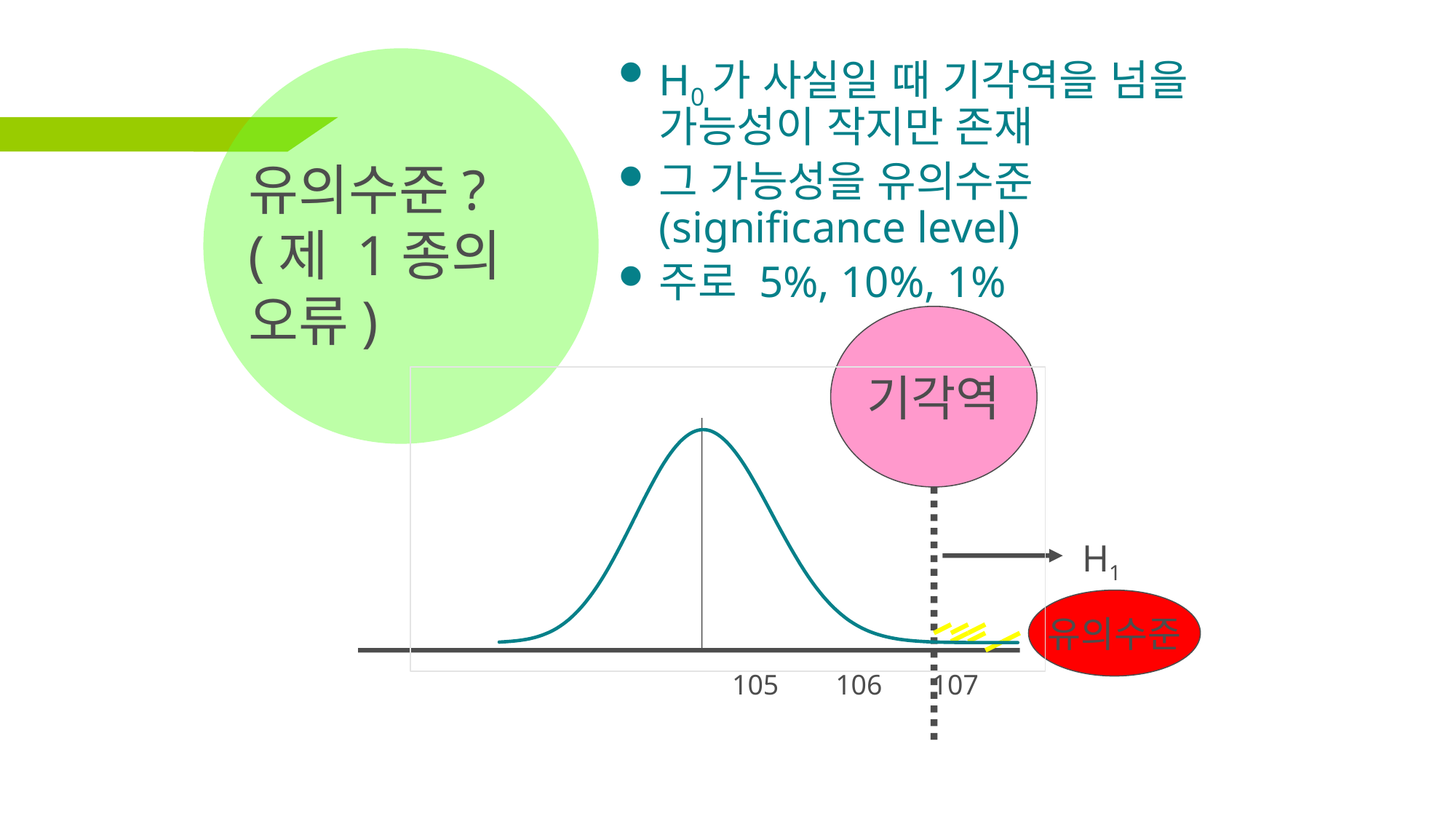
Moving from left to right along the x axis, does the curve rise and then fall, or fall and then rise? rise and then fall Is the peak of the curve located at an x value greater or less than 106? less What label is written in the pink circle above the dashed vertical line on the chart? 기각역 Which x-axis tick label on the curve chart is the smallest? 105 What label is written in the red ellipse at the right end of the x axis? 유의수준 What kind of chart is shown at the bottom of the slide? line chart (bell-shaped curve) Is the curve's height at 107 greater or less than its height at 105? less How many numeric tick labels are shown on the x axis of the curve chart? 3 Which x-axis tick label on the curve chart is the largest? 107 What are the tick labels shown on the x axis of the curve chart? 105, 106, 107